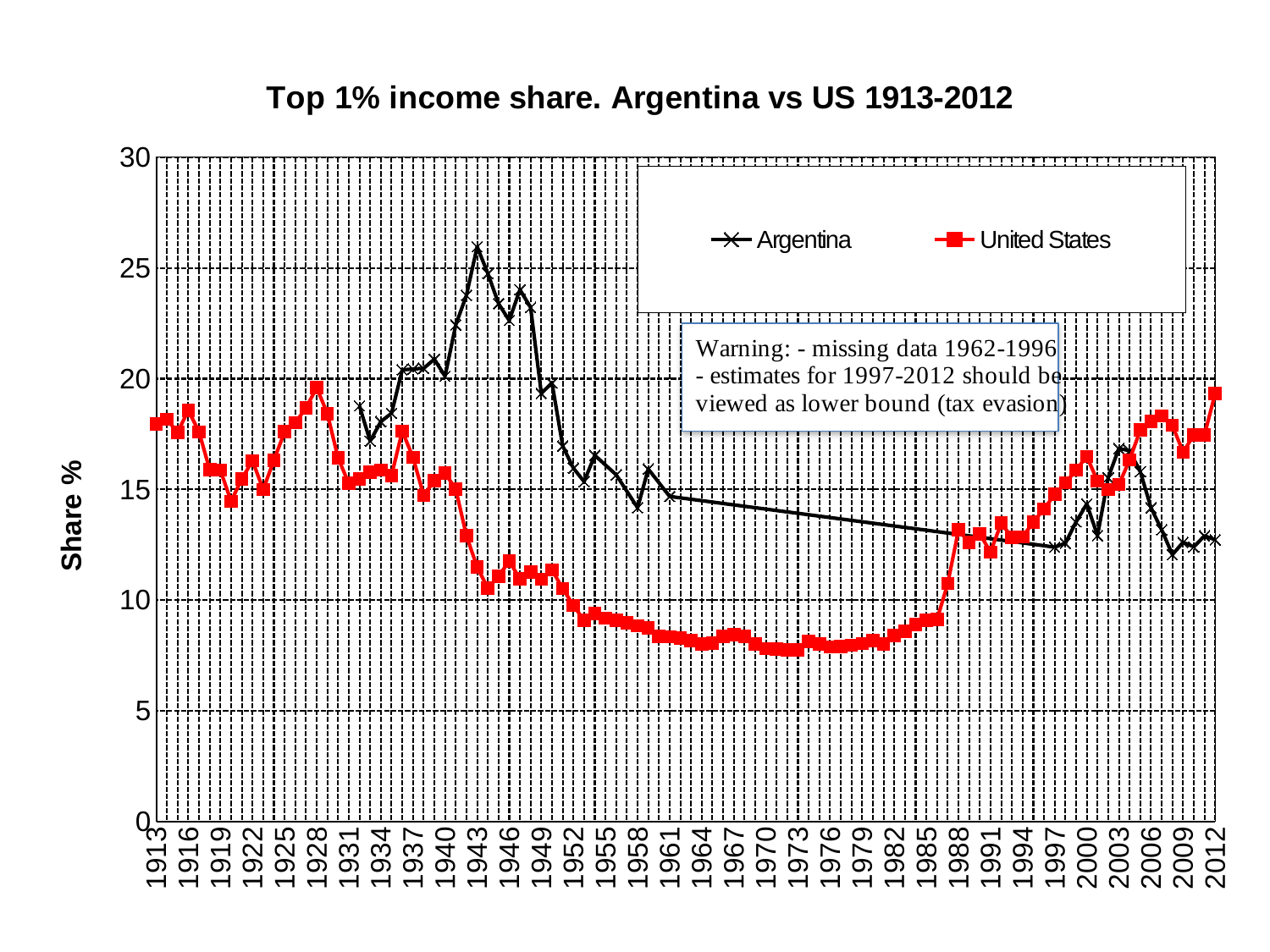
Does the United States series rise or fall between 1929 and 1976? Fall Is the value for the United States in 1913 greater or less than 15? greater In 1943, which series has the higher value, Argentina or the United States? Argentina How many series does the legend list? 2 Is the value for Argentina in 2009 greater or less than 15? less What is the title of the chart? Top 1% income share. Argentina vs US 1913-2012 What kind of chart is shown on the slide? Line chart Is the value for the United States in 2012 greater or less than 15? greater In 2012, which series has the higher value, Argentina or the United States? United States What is the label on the vertical axis? Share %